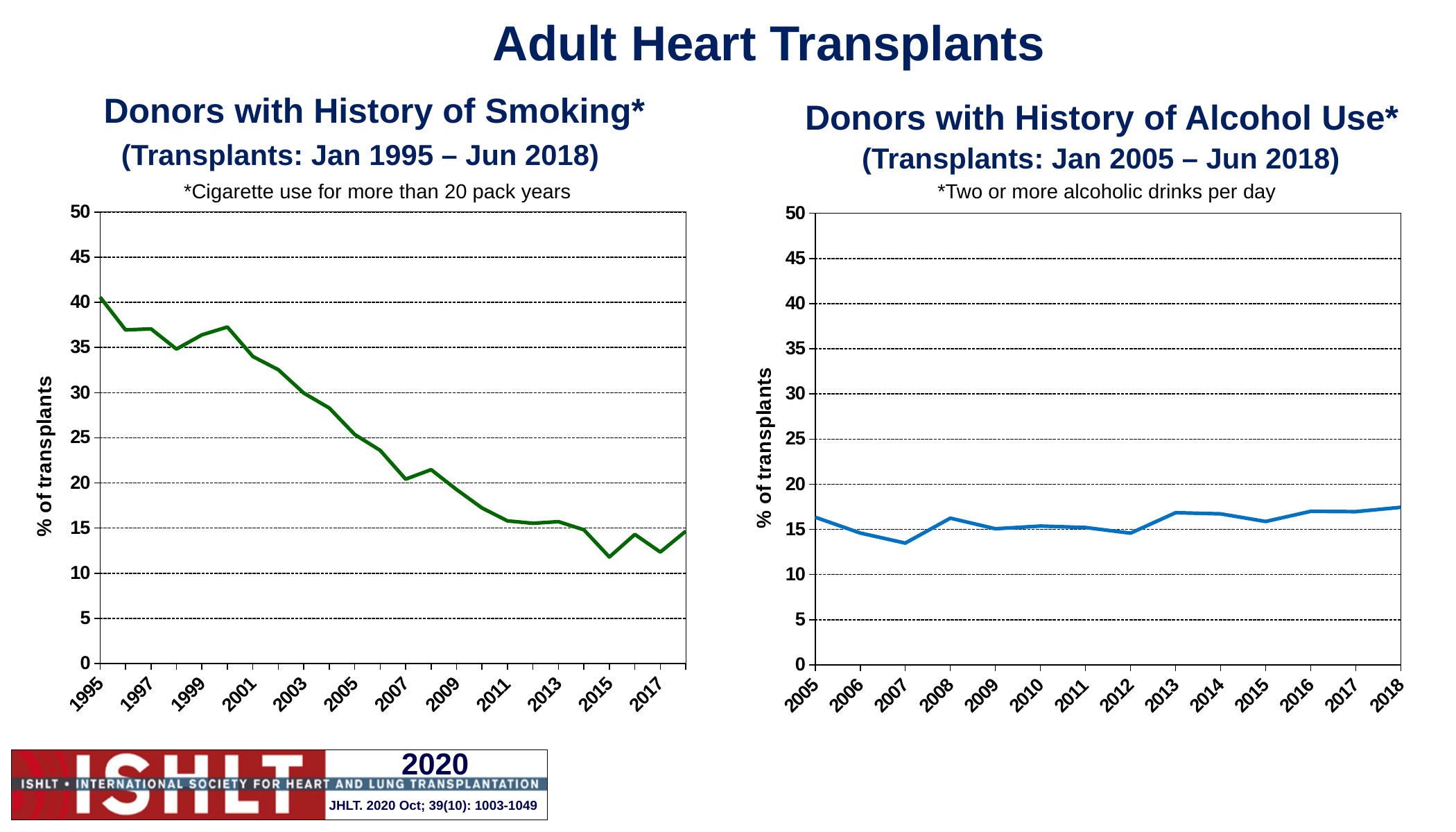
In the 'Donors with History of Smoking' chart, is the value for 2011 greater or less than 20? less What kind of chart is the 'Donors with History of Smoking' chart? line chart What is the y-axis label of the 'Donors with History of Alcohol Use' chart? % of transplants How many years are labeled on the x axis of the 'Donors with History of Alcohol Use' chart? 14 In the 'Donors with History of Smoking' chart, which year has the highest value? 1995 In the 'Donors with History of Alcohol Use' chart, which year has the lowest value? 2007 In the 'Donors with History of Smoking' chart, do the values generally rise or fall from 1995 to 2018? fall In the 'Donors with History of Alcohol Use' chart, is the value for 2007 greater or less than 15? less In the 'Donors with History of Smoking' chart, which is larger, the value for 1995 or the value for 2017? 1995 In the 'Donors with History of Smoking' chart, is the value for 2015 greater or less than 15? less